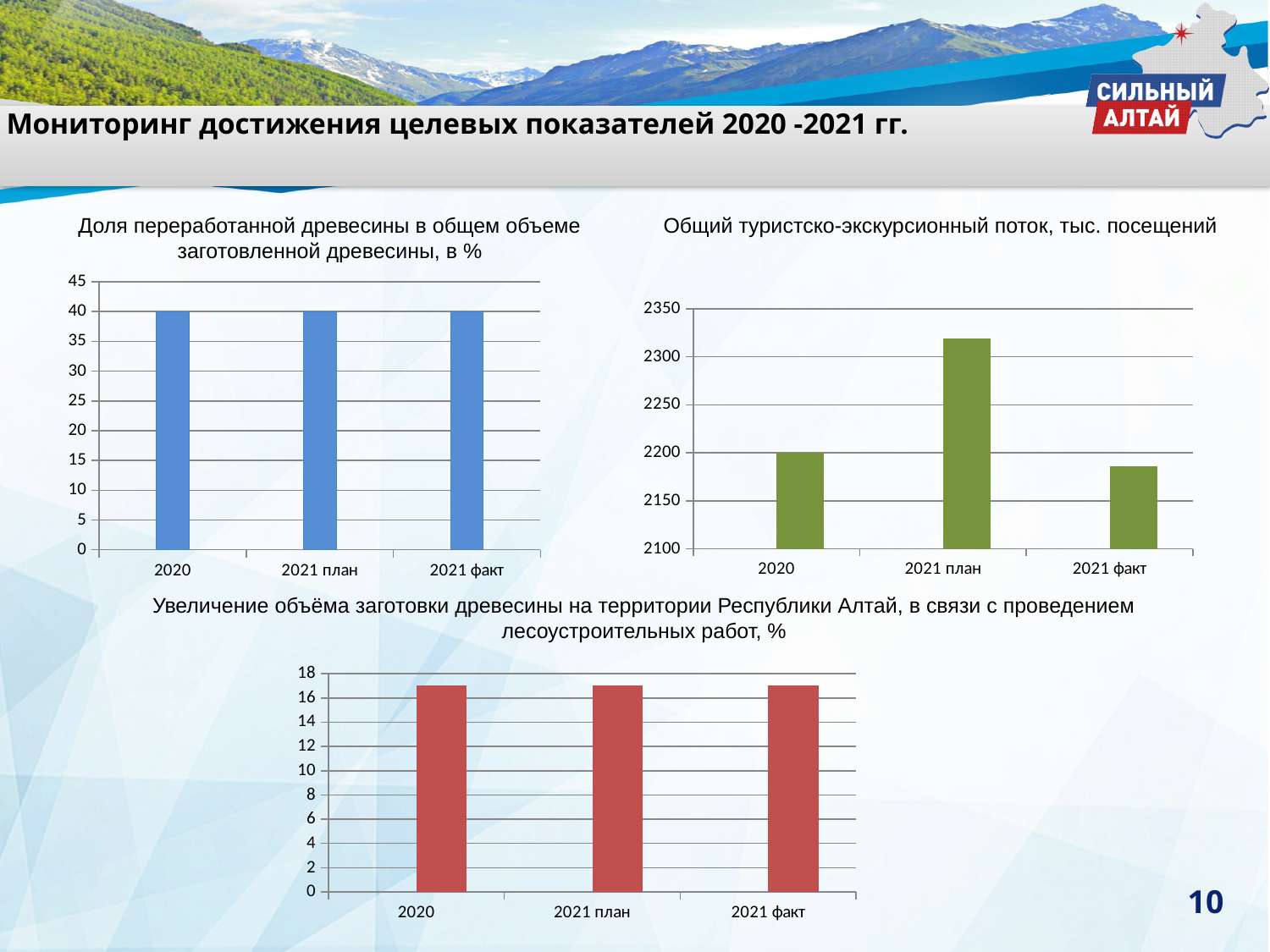
In the chart 'Доля переработанной древесины в общем объеме заготовленной древесины, в %', do the values rise, fall or stay the same across the categories? stay the same In the chart 'Общий туристско-экскурсионный поток, тыс. посещений', is the value for 2021 план greater or less than 2300? greater In the bottom chart 'Увеличение объёма заготовки древесины на территории Республики Алтай...', is the value for 2020 greater or less than 16? greater In the chart 'Общий туристско-экскурсионный поток, тыс. посещений', is the value for 2021 факт greater or less than 2200? less What type of chart is the bottom chart 'Увеличение объёма заготовки древесины на территории Республики Алтай...'? bar chart In the chart 'Общий туристско-экскурсионный поток, тыс. посещений', what is the value for 2020? 2200 How many charts are shown on the slide? 3 In the chart 'Доля переработанной древесины в общем объеме заготовленной древесины, в %', how many categories are shown on the x axis? 3 In the chart 'Общий туристско-экскурсионный поток, тыс. посещений', which is larger: the value for 2021 план or the value for 2021 факт? 2021 план In the chart 'Доля переработанной древесины в общем объеме заготовленной древесины, в %', what is the value for 2020? 40 In the chart 'Общий туристско-экскурсионный поток, тыс. посещений', which category has the highest value? 2021 план In the chart 'Доля переработанной древесины в общем объеме заготовленной древесины, в %', what is the value for 2021 факт? 40